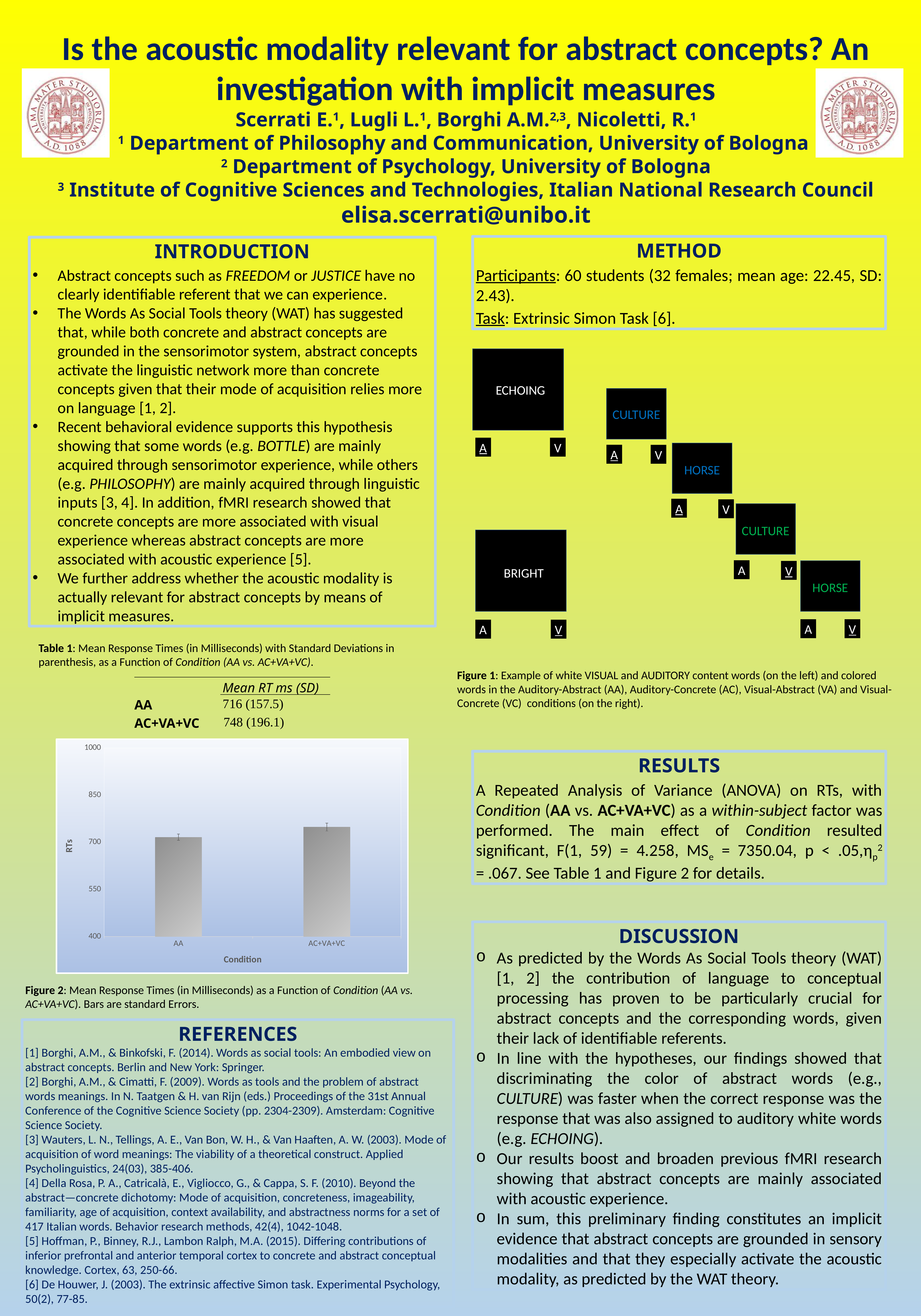
In the Figure 2 chart, is the value for AC+VA+VC greater or less than 850? less Which condition has the lowest mean response time in the Figure 2 chart? AA In the Figure 2 chart, which bar is taller: AA or AC+VA+VC? AC+VA+VC What is the x-axis title of the Figure 2 chart? Condition Which condition has the highest mean response time in the Figure 2 chart? AC+VA+VC In the Figure 2 chart, is the value for AA greater or less than 850? less What is the y-axis label of the Figure 2 chart? RTs Do the bar values in the Figure 2 chart rise or fall from AA to AC+VA+VC? rise How many bars (conditions) are plotted in the Figure 2 chart? 2 In the Figure 2 chart, is the value for AC+VA+VC greater or less than 700? greater What kind of chart is shown in Figure 2? bar chart